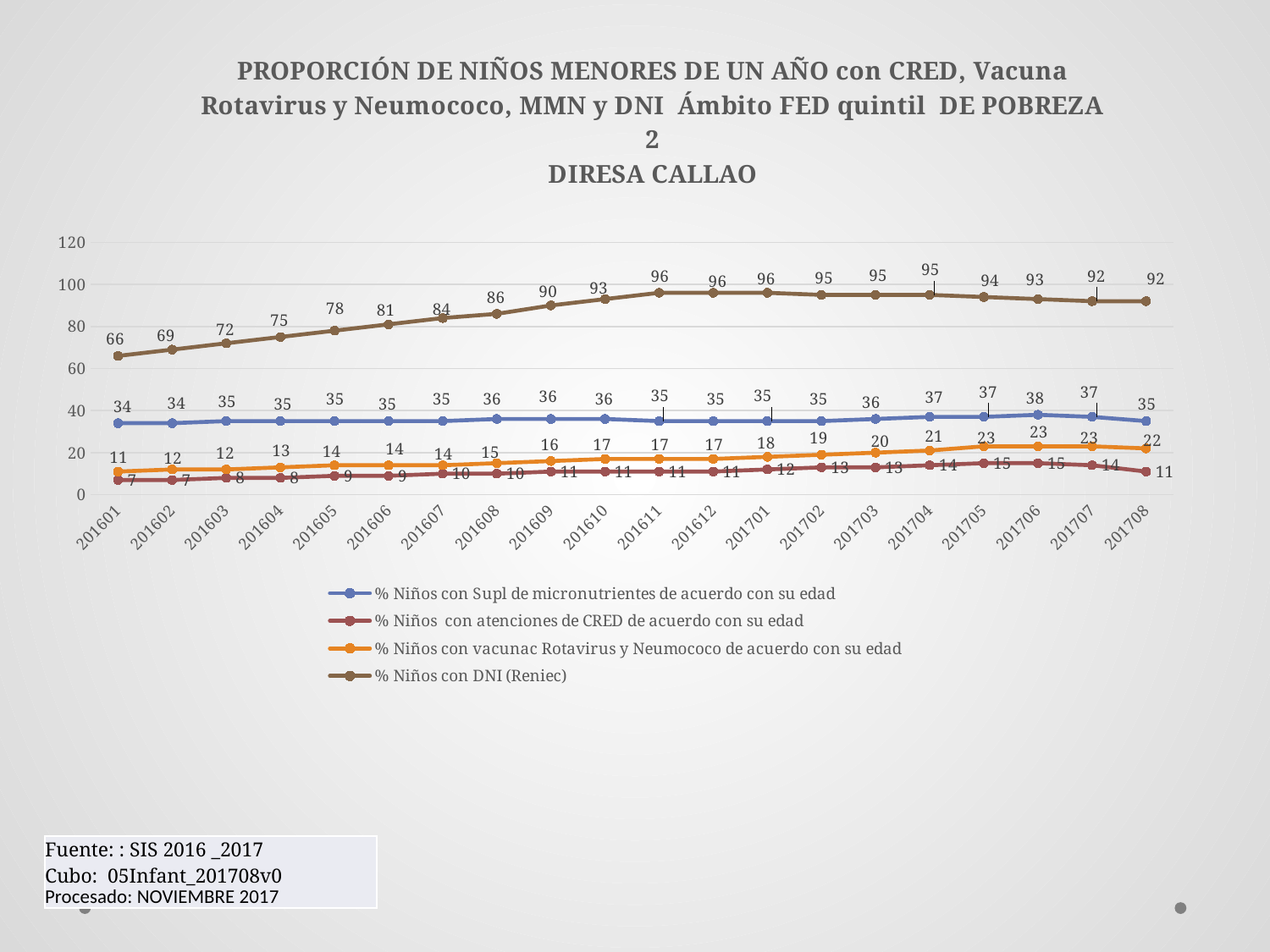
What is the lowest value of % Niños con atenciones de CRED de acuerdo con su edad? 7 How many time periods are shown on the x axis? 20 What is the value of % Niños con vacunac Rotavirus y Neumococo de acuerdo con su edad in 201708? 22 Which series has the higher value in 201704: % Niños con Supl de micronutrientes or % Niños con vacunac Rotavirus y Neumococo? % Niños con Supl de micronutrientes de acuerdo con su edad What is the difference between the % Niños con DNI (Reniec) values in 201611 and 201601? 30 What is the value of % Niños con DNI (Reniec) in 201601? 66 How many series does the legend list? 4 Which DIRESA is named in the chart title? DIRESA CALLAO What is the value of % Niños con atenciones de CRED de acuerdo con su edad in 201705? 15 What type of chart is shown on the slide? line chart In which period does % Niños con Supl de micronutrientes de acuerdo con su edad reach its highest value? 201706 Does % Niños con DNI (Reniec) generally rise or fall from 201601 to 201611? rise